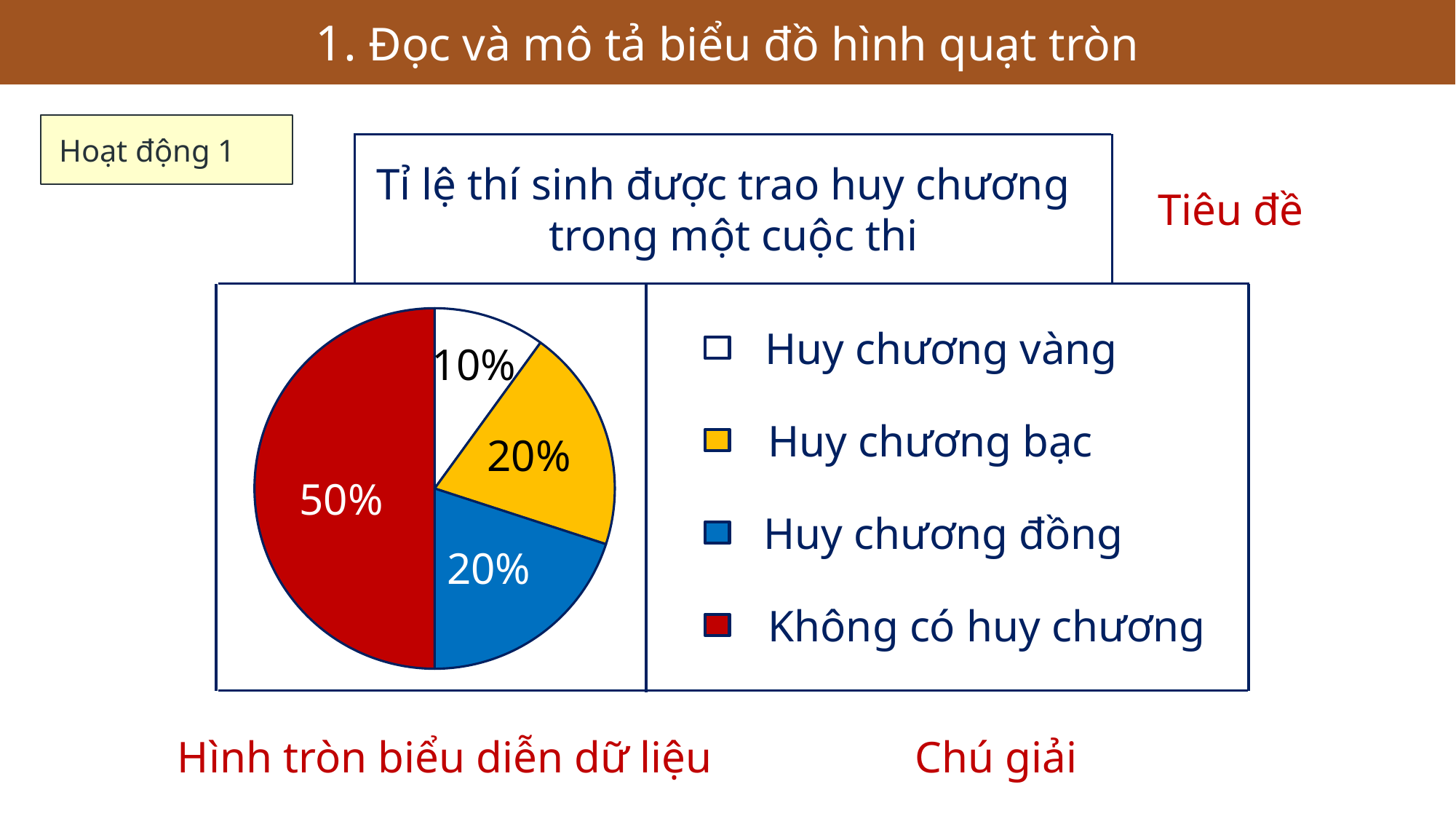
What percentage of the pie chart is labelled for Không có huy chương? 50% What kind of chart is shown on the slide? Pie chart What percentage of the pie chart is labelled for Huy chương bạc? 20% What colour is the slice for Huy chương đồng in the pie chart? Blue Which category has the largest slice of the pie chart? Không có huy chương Which is larger in the pie chart: the share for Huy chương bạc or the share for Huy chương vàng? Huy chương bạc What percentage of the pie chart is labelled for Huy chương vàng? 10% Which category has the smallest slice of the pie chart? Huy chương vàng What is the title of the pie chart? Tỉ lệ thí sinh được trao huy chương trong một cuộc thi How many entries does the legend of the pie chart list? 4 What is the difference between the share for Không có huy chương and the share for Huy chương vàng? 40% How many slices does the pie chart have? 4